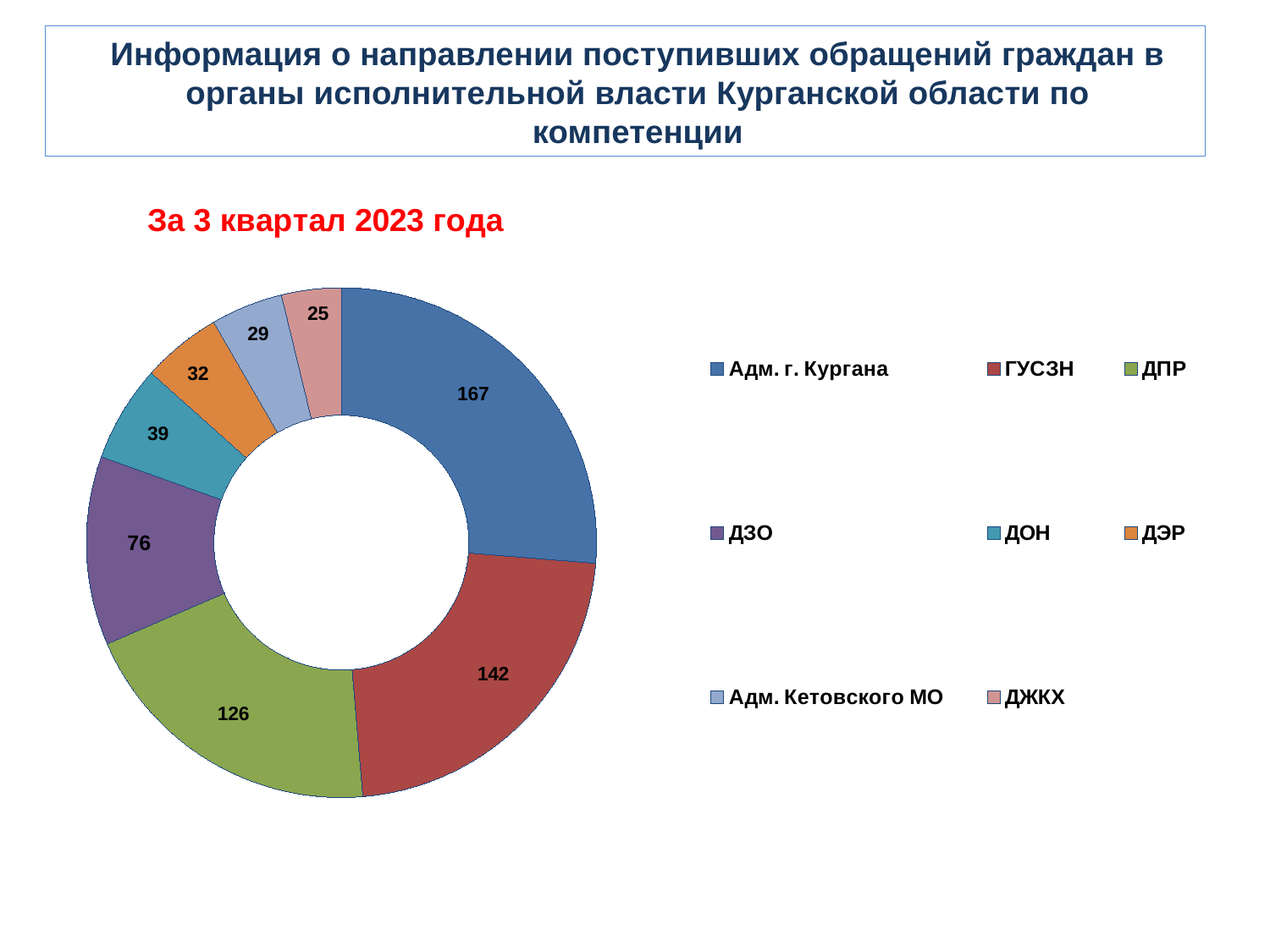
Which category has the highest value? Адм. г. Кургана Which category has the lowest value? ДЖКХ What is the value for Адм. Кетовского МО? 29 How many entries does the legend list? 8 What is the total of all values shown in the chart? 636 What kind of chart is shown on the slide? Doughnut (pie) chart What is the value for ГУСЗН? 142 What is the difference between the values for ГУСЗН and ДПР? 16 Which is larger, the value for ДОН or the value for ДЭР? ДОН What is the value for Адм. г. Кургана? 167 How many categories are shown in the chart? 8 What is the value for ДЗО? 76